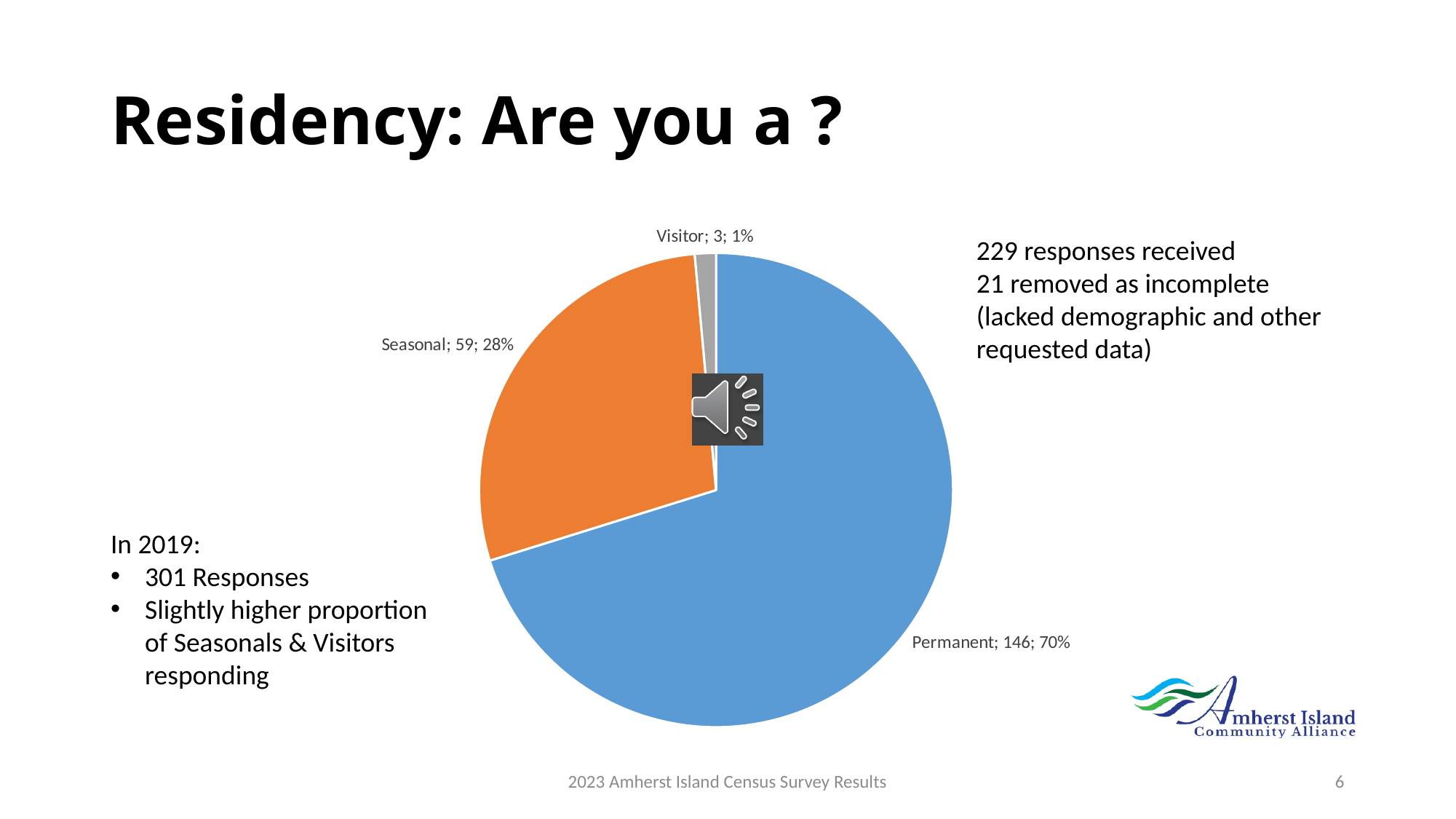
Which category has the smallest slice in the pie chart? Visitor Which is larger, the Seasonal count or the Visitor count? Seasonal How many respondents are Permanent residents according to the pie chart? 146 How many respondents are Visitors according to the pie chart? 3 How many slices does the pie chart have? 3 What colour is the Seasonal slice in the pie chart? orange What share of the pie does the Seasonal slice represent? 28% Which category has the largest slice in the pie chart? Permanent What share of the pie does the Permanent slice represent? 70% What is the difference between the Permanent and Seasonal counts? 87 What kind of chart is shown on the slide? pie chart How many respondents are Seasonal according to the pie chart? 59